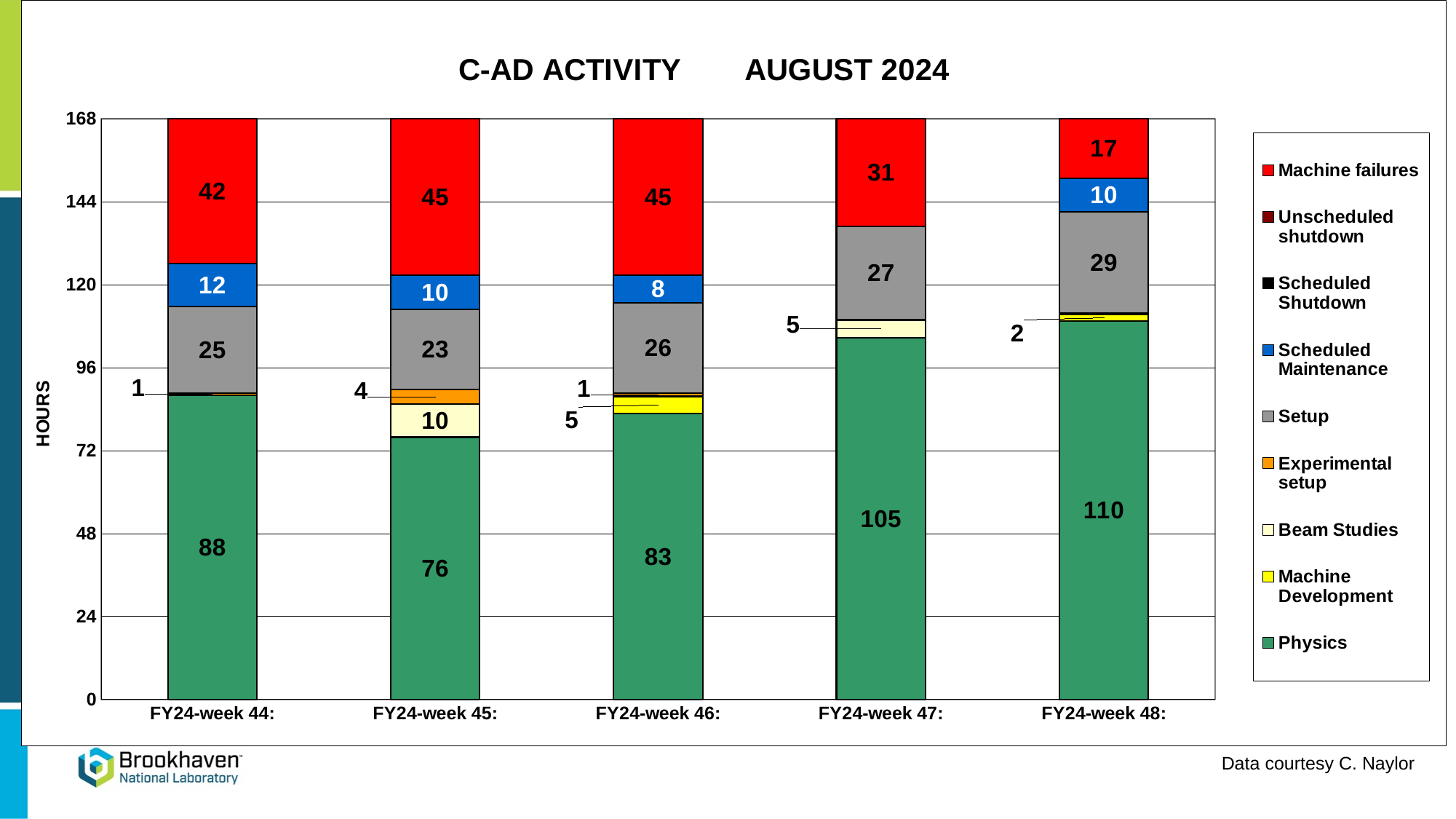
What is the Machine failures value for FY24-week 47? 31 Which week has the lowest Machine failures hours? FY24-week 48: Which week has the highest Physics hours? FY24-week 48: What is the difference in Physics hours between FY24-week 48 and FY24-week 44? 22 How many hours of Physics are shown for FY24-week 48? 110 What is the total height of the stacked bar for FY24-week 44? 168 How many series does the legend list? 9 What is the Beam Studies value for FY24-week 45? 10 What kind of chart is shown on the slide? Stacked bar chart Which week has more Setup hours, FY24-week 46 or FY24-week 47? FY24-week 47: How many weeks are shown on the x axis? 5 How many hours of Setup are shown for FY24-week 45? 23